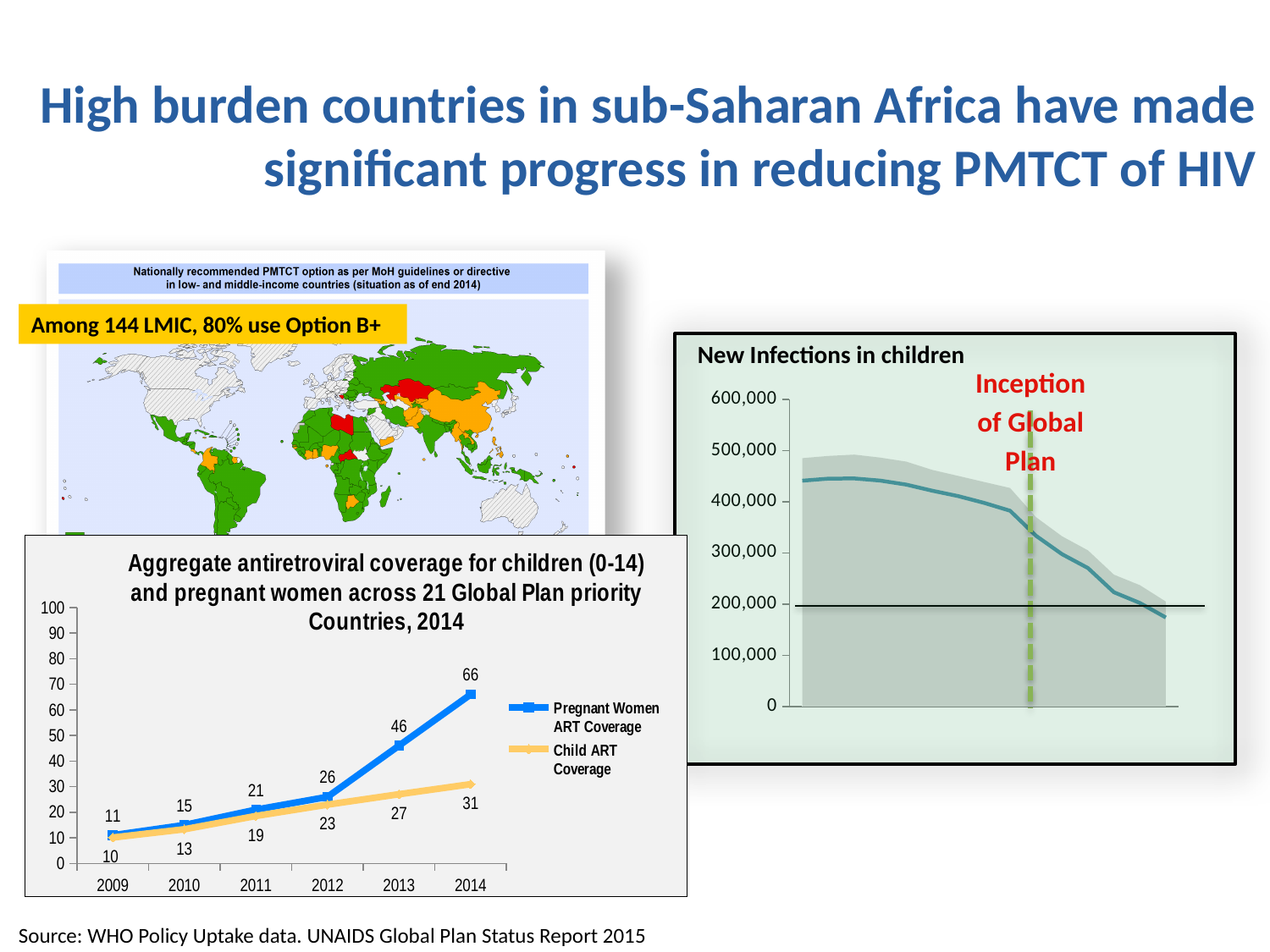
In the 'Aggregate antiretroviral coverage' chart, what is the Child ART Coverage value for 2011? 19 In the 'New Infections in children' chart, is the value at the last point of the line greater or less than 200,000? less In the 'Aggregate antiretroviral coverage' chart, what is the Pregnant Women ART Coverage value for 2014? 66 How many years are shown on the x axis of the 'Aggregate antiretroviral coverage' chart? 6 In the 'Aggregate antiretroviral coverage' chart, which year has the lowest Child ART Coverage? 2009 How many series does the legend of the 'Aggregate antiretroviral coverage' chart list? 2 In the 'Aggregate antiretroviral coverage' chart, what is the Pregnant Women ART Coverage value for 2012? 26 In the 'Aggregate antiretroviral coverage' chart, does Pregnant Women ART Coverage rise or fall from 2009 to 2014? rise What kind of chart is the 'New Infections in children' chart? combination area and line chart In the 'Aggregate antiretroviral coverage' chart, which is larger in 2013: Pregnant Women ART Coverage or Child ART Coverage? Pregnant Women ART Coverage In the 'Aggregate antiretroviral coverage' chart, what is the difference between Pregnant Women ART Coverage and Child ART Coverage in 2014? 35 In the 'Aggregate antiretroviral coverage' chart, which year has the highest Pregnant Women ART Coverage? 2014